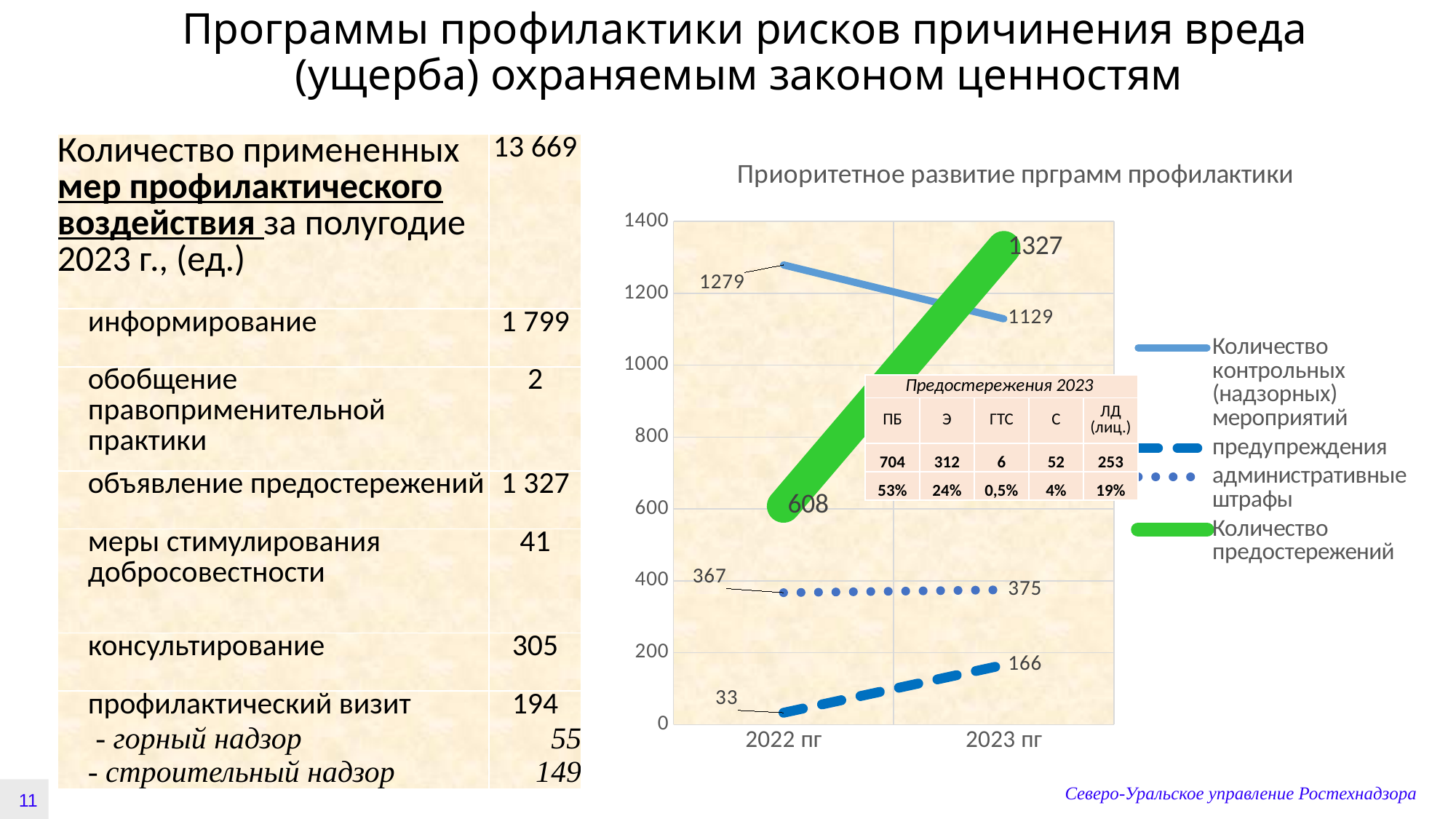
What type of chart is shown on the slide? line chart Does the "Количество контрольных (надзорных) мероприятий" series rise or fall from 2022 пг to 2023 пг? fall What is the value of "административные штрафы" for 2022 пг? 367 What is the value of "предупреждения" for 2023 пг? 166 Which series has the lowest value in 2022 пг? предупреждения How many series does the chart legend list? 4 What is the value of "Количество предостережений" for 2023 пг? 1327 How many categories are shown on the x axis of the chart? 2 By how much did "Количество предостережений" change from 2022 пг (608) to 2023 пг (1327)? 719 Which is larger in 2023 пг: "Количество предостережений" or "Количество контрольных (надзорных) мероприятий"? Количество предостережений Does the "Количество предостережений" series rise or fall from 2022 пг to 2023 пг? rise What is the value of "Количество контрольных (надзорных) мероприятий" for 2022 пг? 1279